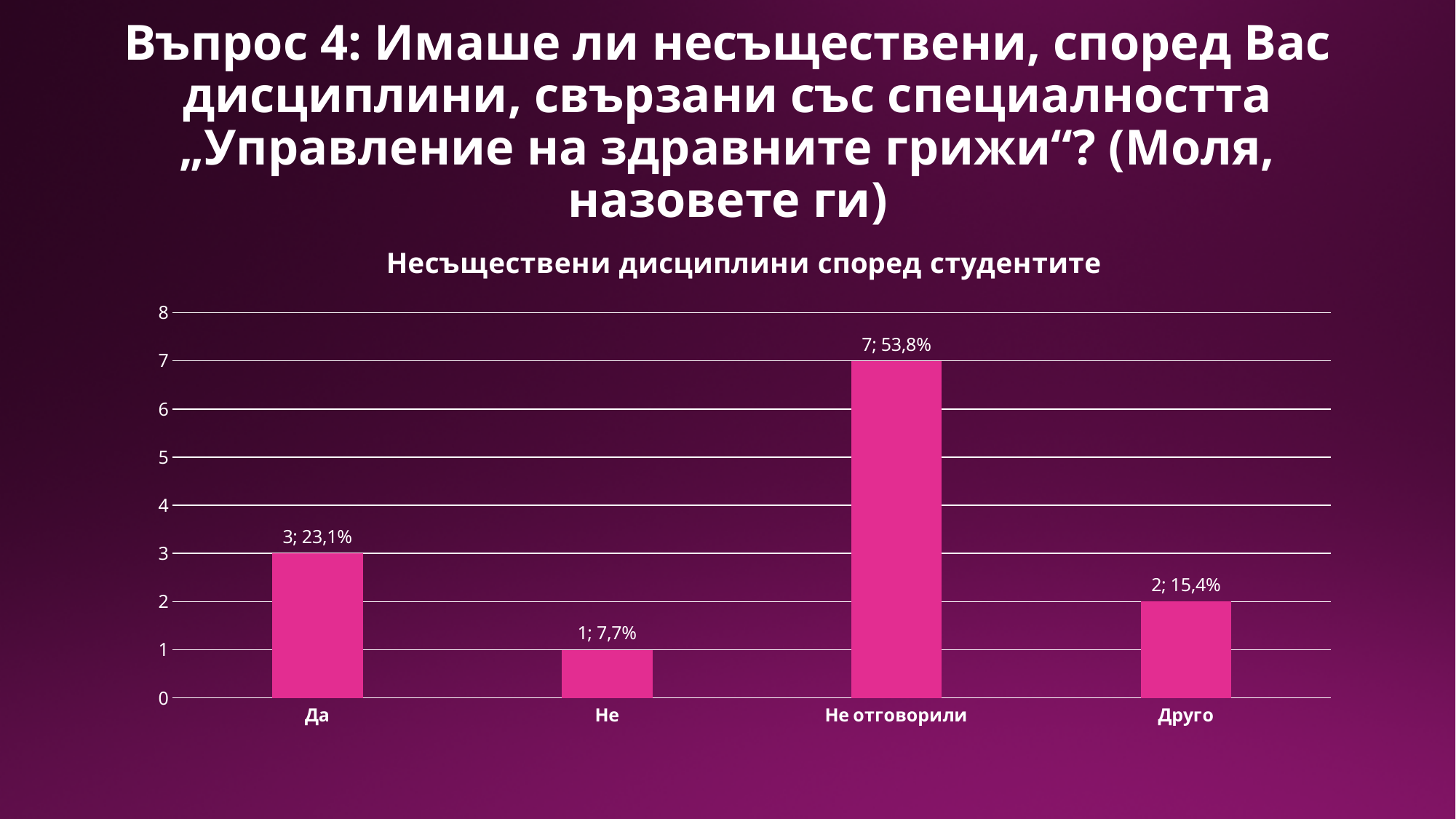
Which category has the lowest value? Не What kind of chart is shown on the slide? bar chart What is the title of the chart? Несъществени дисциплини според студентите What is the difference between the counts for "Не отговорили" and "Да"? 4 How many categories are shown on the x axis? 4 Which category has the highest value? Не отговорили Is the value for "Не отговорили" greater or less than 6? greater What is the count for the category "Да"? 3 What percentage is shown for "Не отговорили"? 53,8% What is the count for "Друго"? 2 Which is larger, the value for "Да" or the value for "Друго"? Да What percentage is shown for "Не"? 7,7%